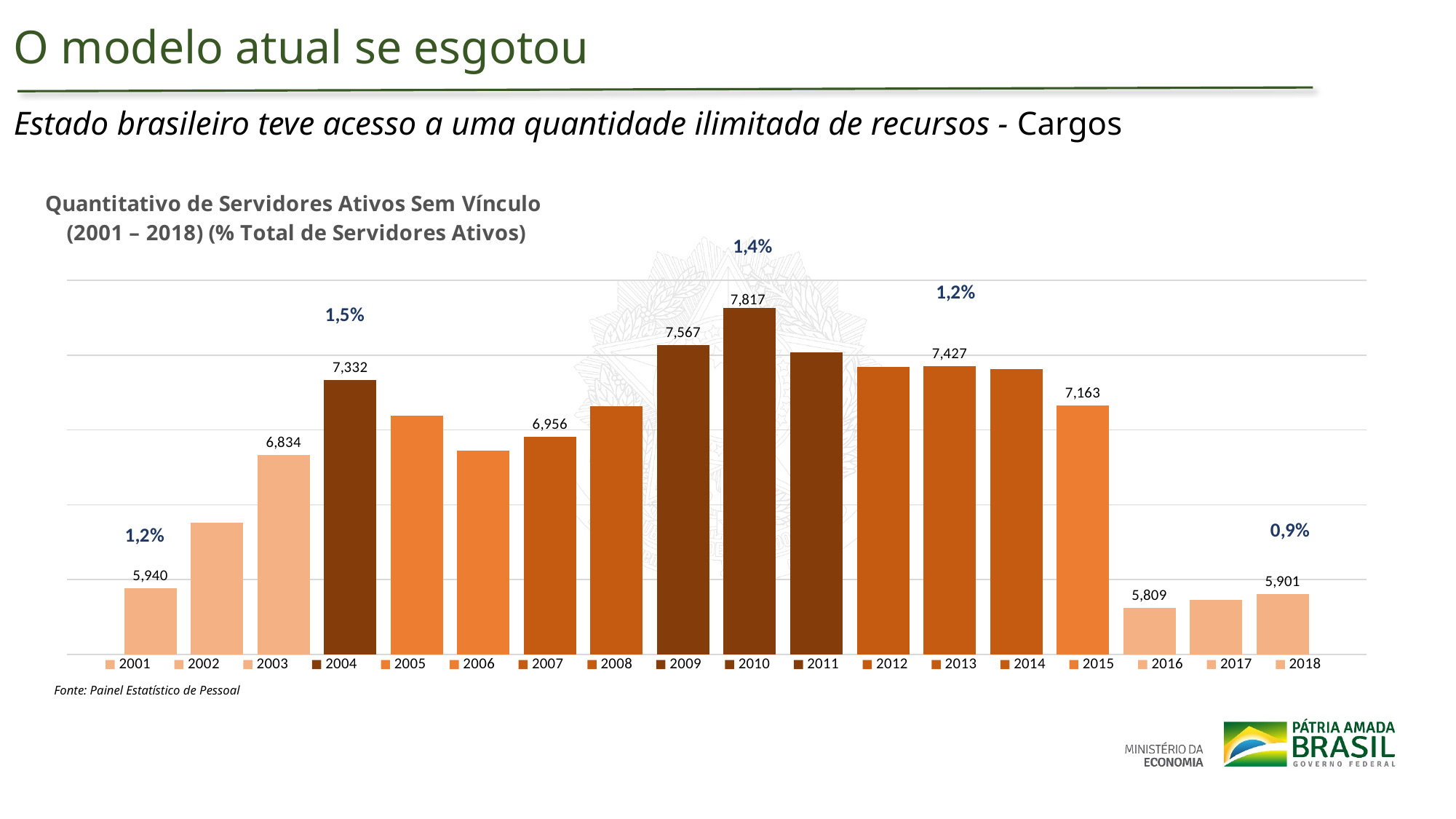
Which is larger, the value for 2009 or the value for 2013? 2009 What is the value for 2015? 7,163 What is the difference between the values for 2004 and 2003? 498 Which year has the lowest value? 2016 What kind of chart is shown? bar chart What percentage is shown above the 2018 bar? 0,9% What is the value for 2010? 7,817 How many years are shown on the x axis? 18 What is the difference between the values for 2010 and 2001? 1,877 What percentage of total active servants is shown above the 2004 bar? 1,5% Which year has the highest value? 2010 What is the value for 2001? 5,940